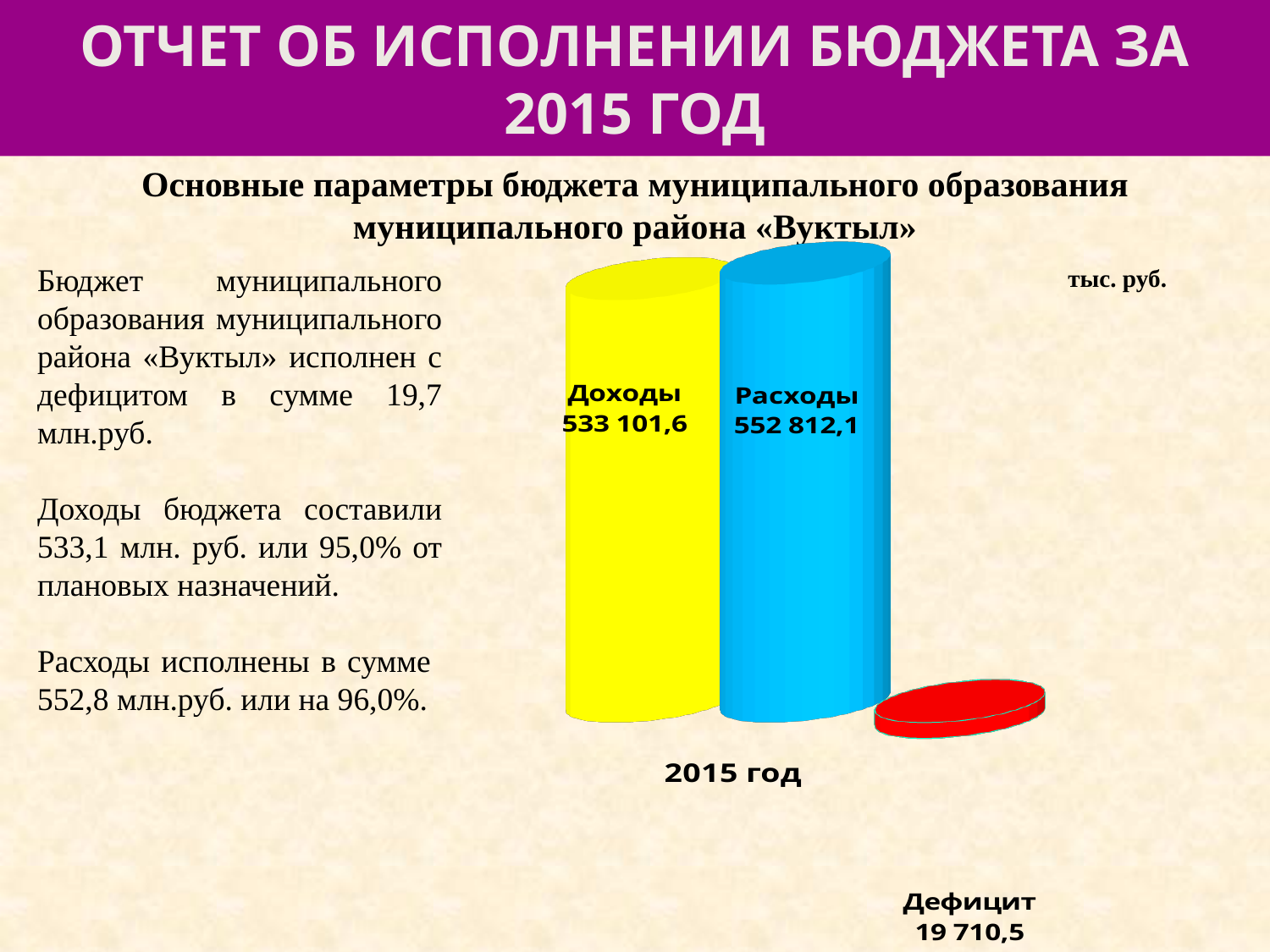
Which bar on the chart has the lowest value? Дефицит How many bars are plotted on the chart? 3 What is the value of Доходы on the chart? 533 101,6 Which bar on the chart has the highest value? Расходы Which is larger on the chart, Доходы or Расходы? Расходы What kind of chart is shown on the slide? Bar chart What is the value of Дефицит on the chart? 19 710,5 What unit is indicated for the values on the chart? тыс. руб. What is the value of Расходы on the chart? 552 812,1 What is the difference between Расходы and Доходы on the chart? 19 710,5 Which year is labelled on the x axis of the chart? 2015 год